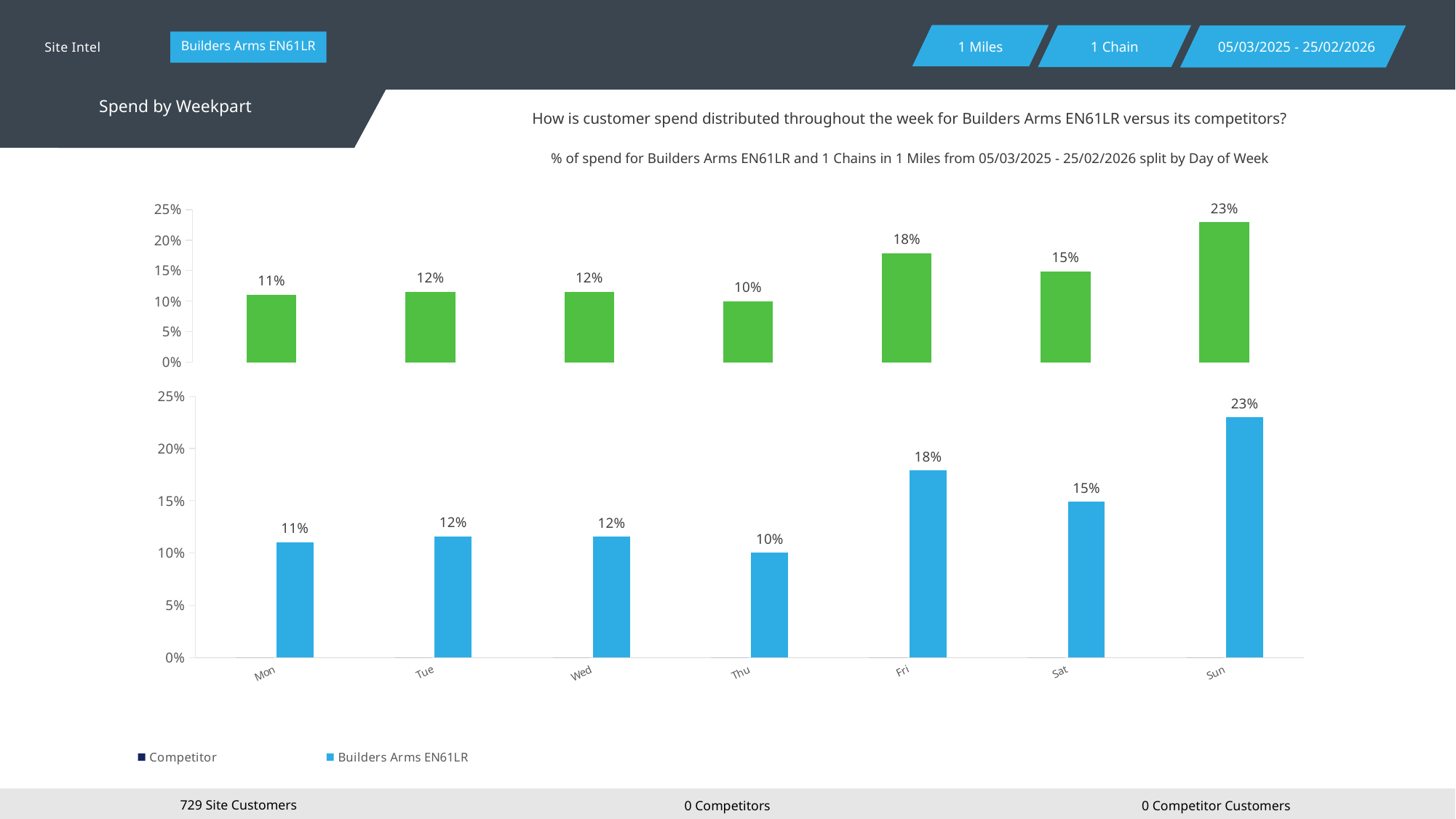
How many series does the legend at the bottom of the slide list? 2 In the top chart, what is the value shown on the last (rightmost) bar? 23% In the bottom chart, is the value for Sun greater or less than 20%? greater In the bottom chart, which day has the highest value? Sun In the bottom chart, what is the difference between the values for Sun and Sat? 8% What kind of chart is the top chart with green bars? bar chart In the bottom chart, which day has the lowest value? Thu In the bottom chart, what is the value for Sun? 23% In the bottom chart, what is the value for Fri? 18% How many days are shown on the x axis of the bottom chart? 7 In the bottom chart, what is the value for Thu? 10% In the bottom chart, which is larger, the value for Fri or the value for Sat? Fri